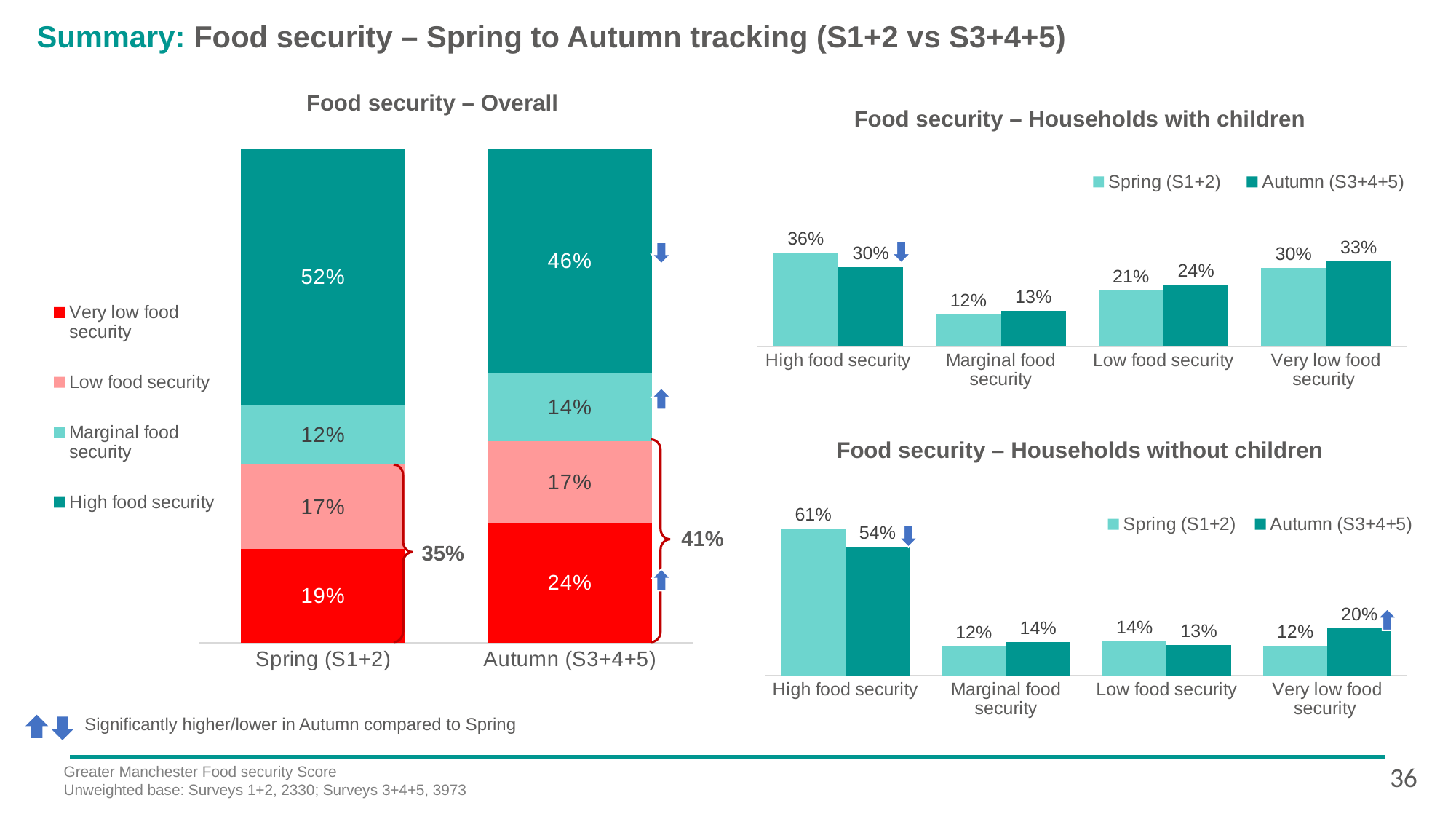
In the 'Food security – Households without children' chart, which is larger for Very low food security: Spring (S1+2) or Autumn (S3+4+5)? Autumn (S3+4+5) How many categories are shown on the x axis of the 'Food security – Households without children' chart? 4 In the 'Food security – Overall' chart, what is the combined Low and Very low food security share for Autumn (S3+4+5)? 41% In the 'Food security – Households with children' chart, what is the Autumn (S3+4+5) value for Low food security? 24% In the 'Food security – Overall' chart, what is the Very low food security value for Autumn (S3+4+5)? 24% In the 'Food security – Households without children' chart, what is the Spring (S1+2) value for High food security? 61% In the 'Food security – Overall' chart, what is the difference between the High food security values for Spring (S1+2) and Autumn (S3+4+5)? 6% What kind of chart is 'Food security – Overall'? Stacked bar chart In the 'Food security – Households with children' chart, what is the difference between Spring (S1+2) and Autumn (S3+4+5) for High food security? 6% How many series does the legend of the 'Food security – Overall' chart list? 4 In the 'Food security – Households with children' chart, which category has the highest Spring (S1+2) value? High food security In the 'Food security – Overall' chart, what is the High food security value for Spring (S1+2)? 52%